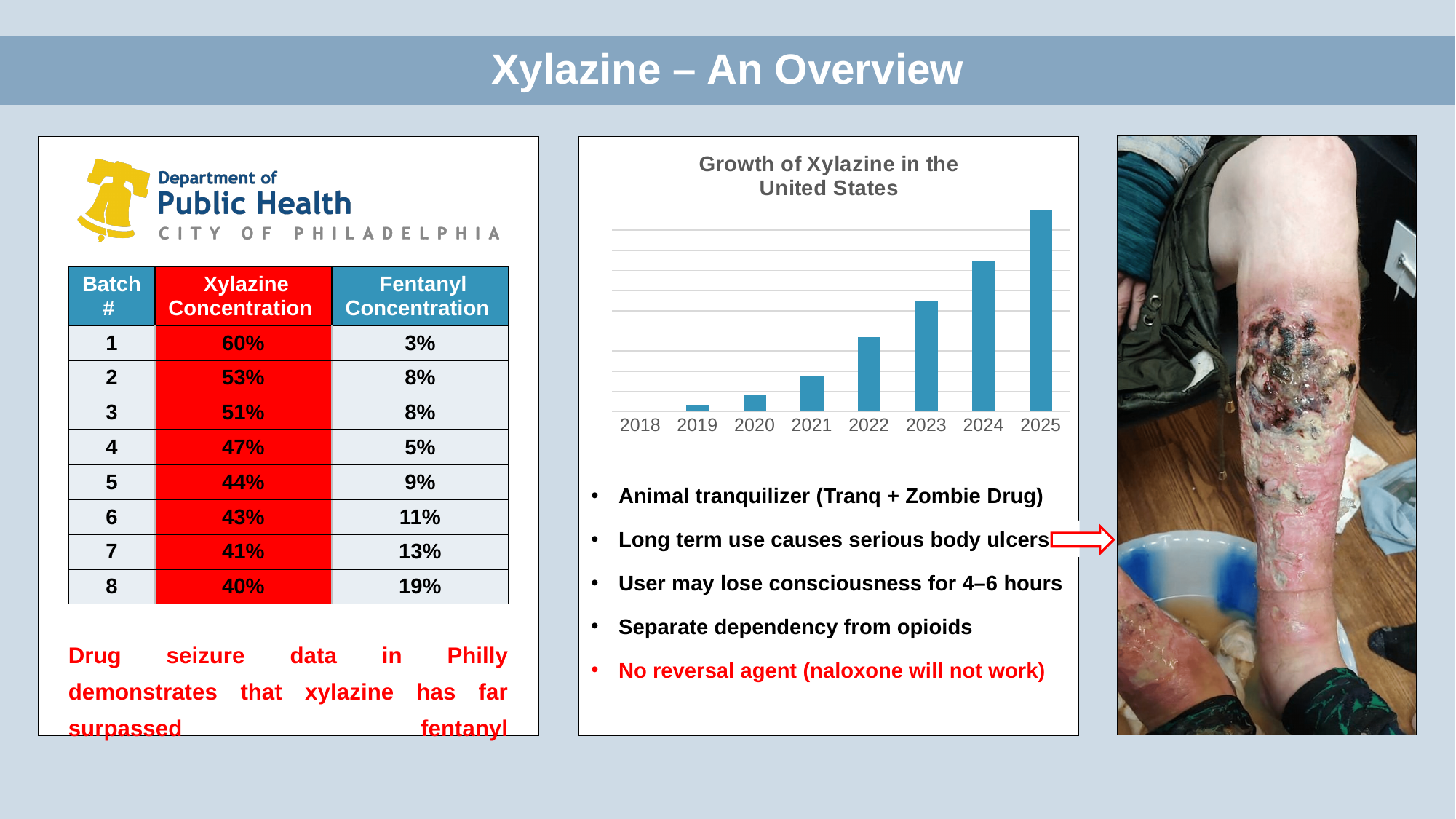
What is the title of the chart on the slide? Growth of Xylazine in the United States Which year has the highest bar in the 'Growth of Xylazine in the United States' chart? 2025 What is the first year shown on the x axis of the 'Growth of Xylazine in the United States' chart? 2018 In the 'Growth of Xylazine in the United States' chart, which is larger, the bar for 2023 or the bar for 2020? 2023 What kind of chart is 'Growth of Xylazine in the United States'? bar chart Which year has the lowest bar in the 'Growth of Xylazine in the United States' chart? 2018 In the 'Growth of Xylazine in the United States' chart, which is larger, the bar for 2022 or the bar for 2024? 2024 In the 'Growth of Xylazine in the United States' chart, do the values rise or fall from 2018 to 2025? rise In the 'Growth of Xylazine in the United States' chart, which is larger, the bar for 2019 or the bar for 2021? 2021 How many years are shown on the x axis of the 'Growth of Xylazine in the United States' chart? 8